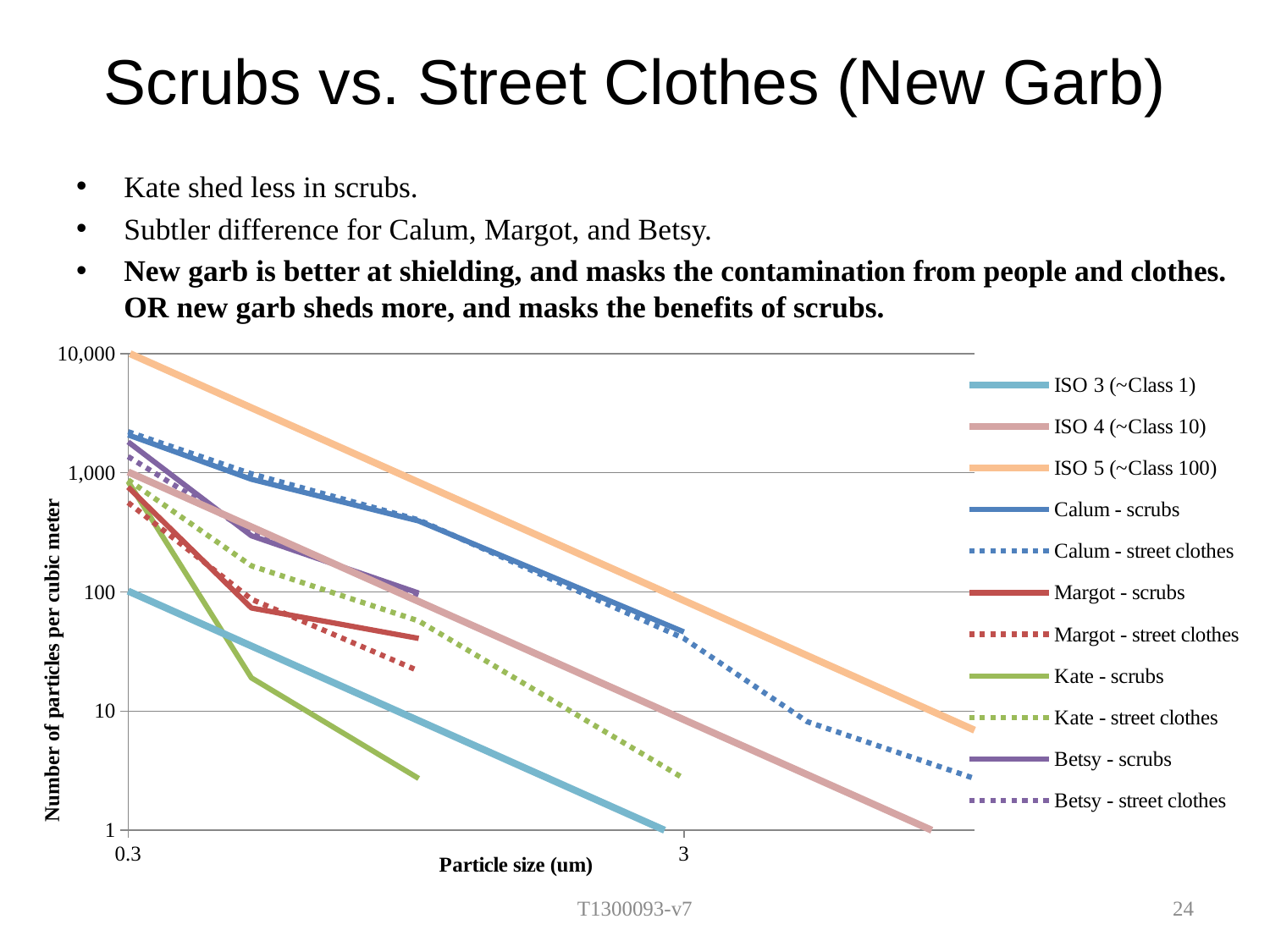
What is the title of the y axis? Number of particles per cubic meter What is the value of the ISO 5 (~Class 100) line at a particle size of 0.3 um? 10,000 Is the value for Margot - scrubs at a particle size of 0.3 um greater or less than 1,000? less Is the value for Calum - street clothes at a particle size of 3 um greater or less than 100? less Is the value for Calum - scrubs at a particle size of 0.3 um greater or less than 1,000? greater What kind of chart is shown on the slide? line chart Which series has the lowest value at a particle size of 0.3 um? ISO 3 (~Class 1) What is the value of the ISO 3 (~Class 1) line at a particle size of 0.3 um? 100 How many series does the chart legend list? 11 At a particle size of 0.3 um, which is higher: Calum - scrubs or Kate - scrubs? Calum - scrubs Which series has the highest value at a particle size of 0.3 um? ISO 5 (~Class 100) Do the values of the series rise or fall as particle size increases along the x axis? fall